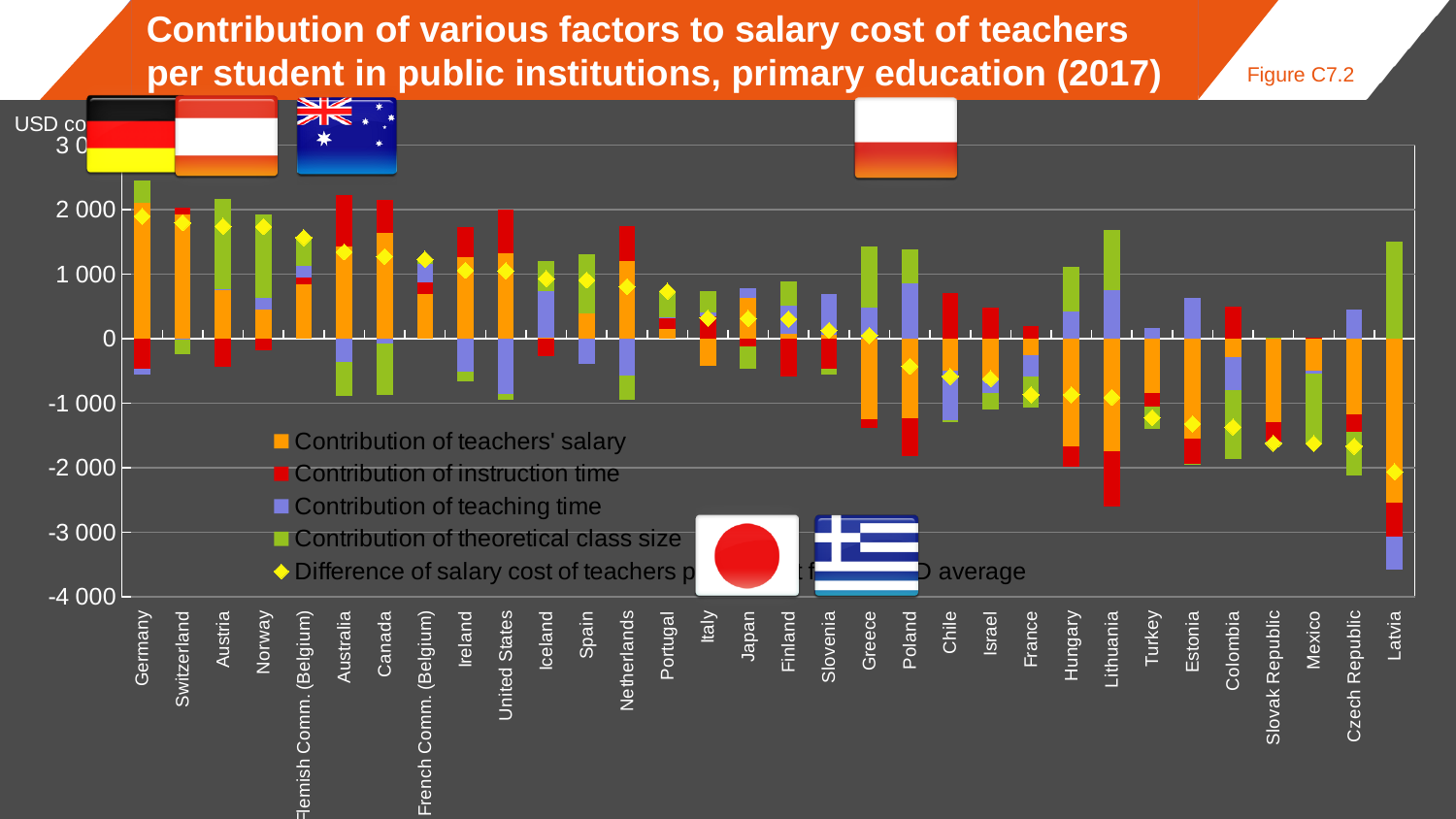
What kind of chart is shown on the slide? Stacked bar chart with diamond markers Which country has the lowest diamond marker for the difference of salary cost of teachers per student from the OECD average? Latvia Which has the larger diamond marker value, Germany or Latvia? Germany Is the diamond marker value for Germany greater or less than 1 000? greater Is the diamond marker value for Slovak Republic greater or less than -1 000? less What figure number is given for this chart? Figure C7.2 Which country has the highest diamond marker for the difference of salary cost of teachers per student from the OECD average? Germany Do the diamond marker values generally rise or fall moving from left to right along the x axis? Fall How many countries or regions are listed along the x axis? 32 Is the diamond marker value for Latvia greater or less than -1 000? less How many series does the legend list? 5